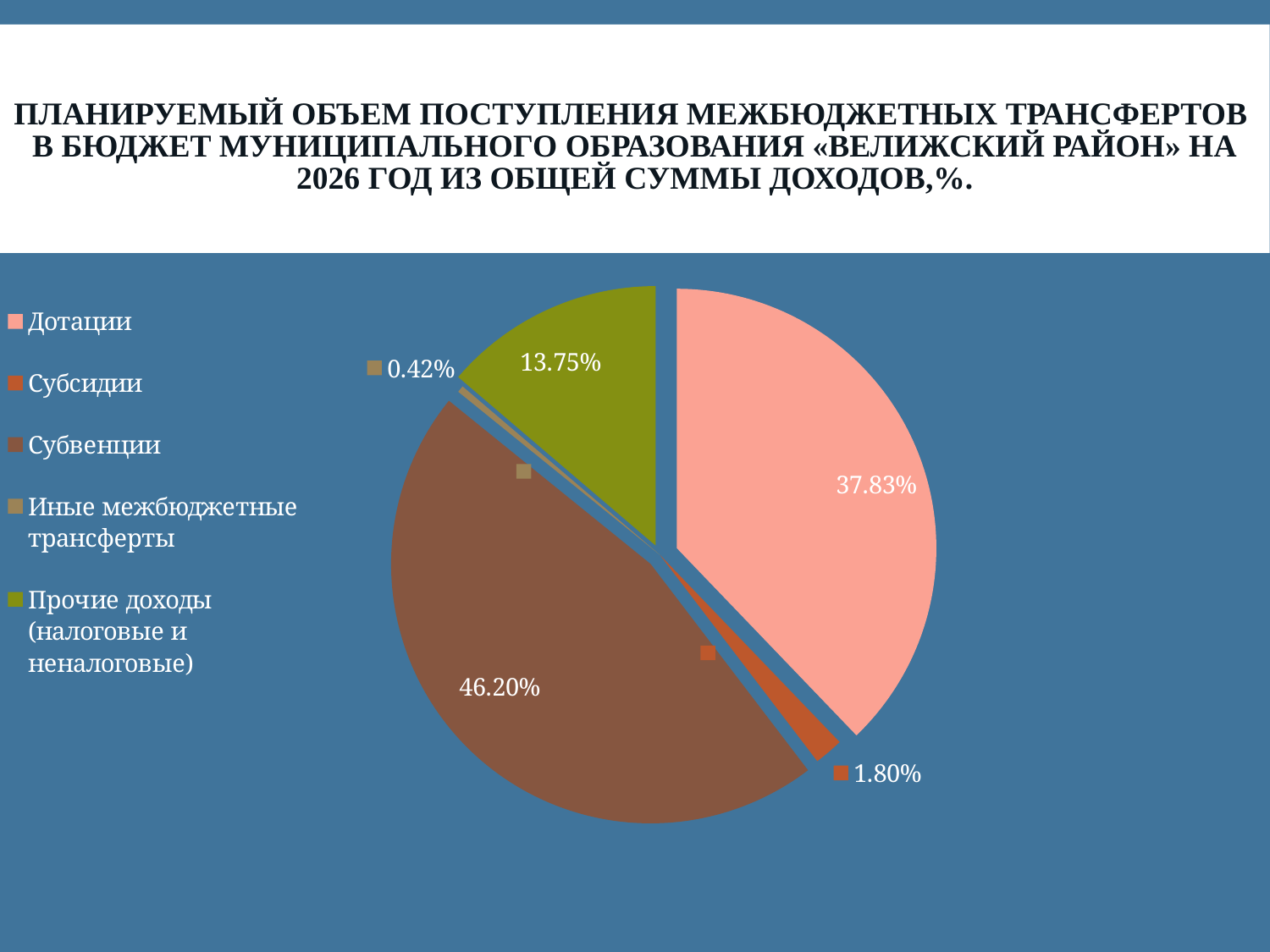
What kind of chart is shown on the slide? Pie chart What colour is the slice for Прочие доходы (налоговые и неналоговые)? Green What is the value for Субвенции? 46.20% What is the difference between the values for Субвенции and Дотации? 8.37% Which is larger, the value for Прочие доходы (налоговые и неналоговые) or the value for Субсидии? Прочие доходы (налоговые и неналоговые) What is the value for Иные межбюджетные трансферты? 0.42% What is the value for Дотации? 37.83% What is the value for Прочие доходы (налоговые и неналоговые)? 13.75% What is the value for Субсидии? 1.80% Which category has the largest share of the pie? Субвенции Which category has the smallest share of the pie? Иные межбюджетные трансферты How many categories does the pie chart show? 5